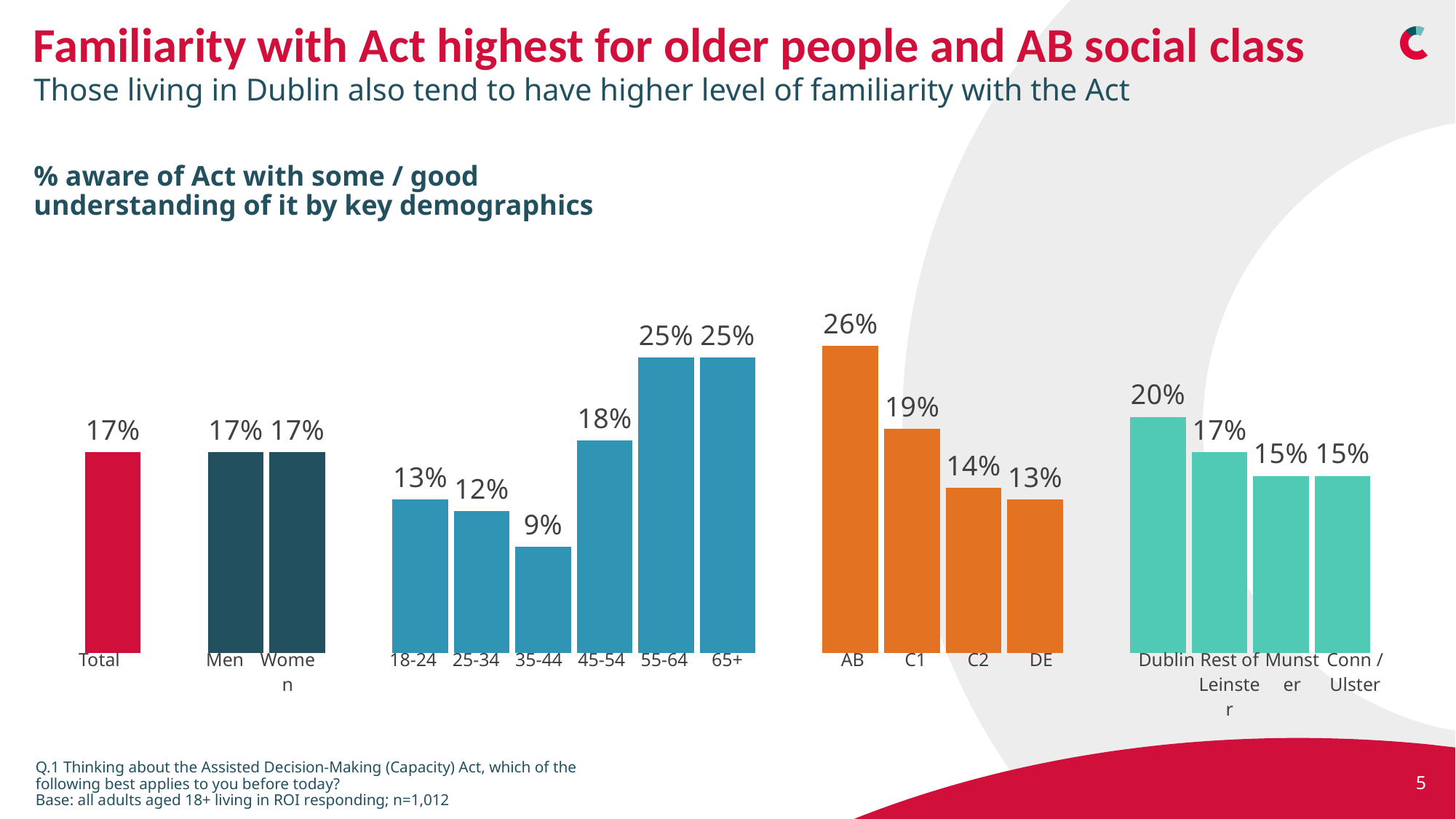
Which social class category has the lowest value? DE What is the difference between the values for 65+ and 18-24? 12% What kind of chart is shown on the slide? Bar chart What is the difference between the values for AB and DE? 13% What is the value for Dublin? 20% What is the value for the AB social class? 26% Which is larger, the value for Dublin or the value for Munster? Dublin What is the value for Total? 17% Which age group has the lowest value? 35-44 What is the value for the 35-44 age group? 9% How many age group categories are shown? 6 Do the values rise or fall across the social class categories from AB to DE? Fall